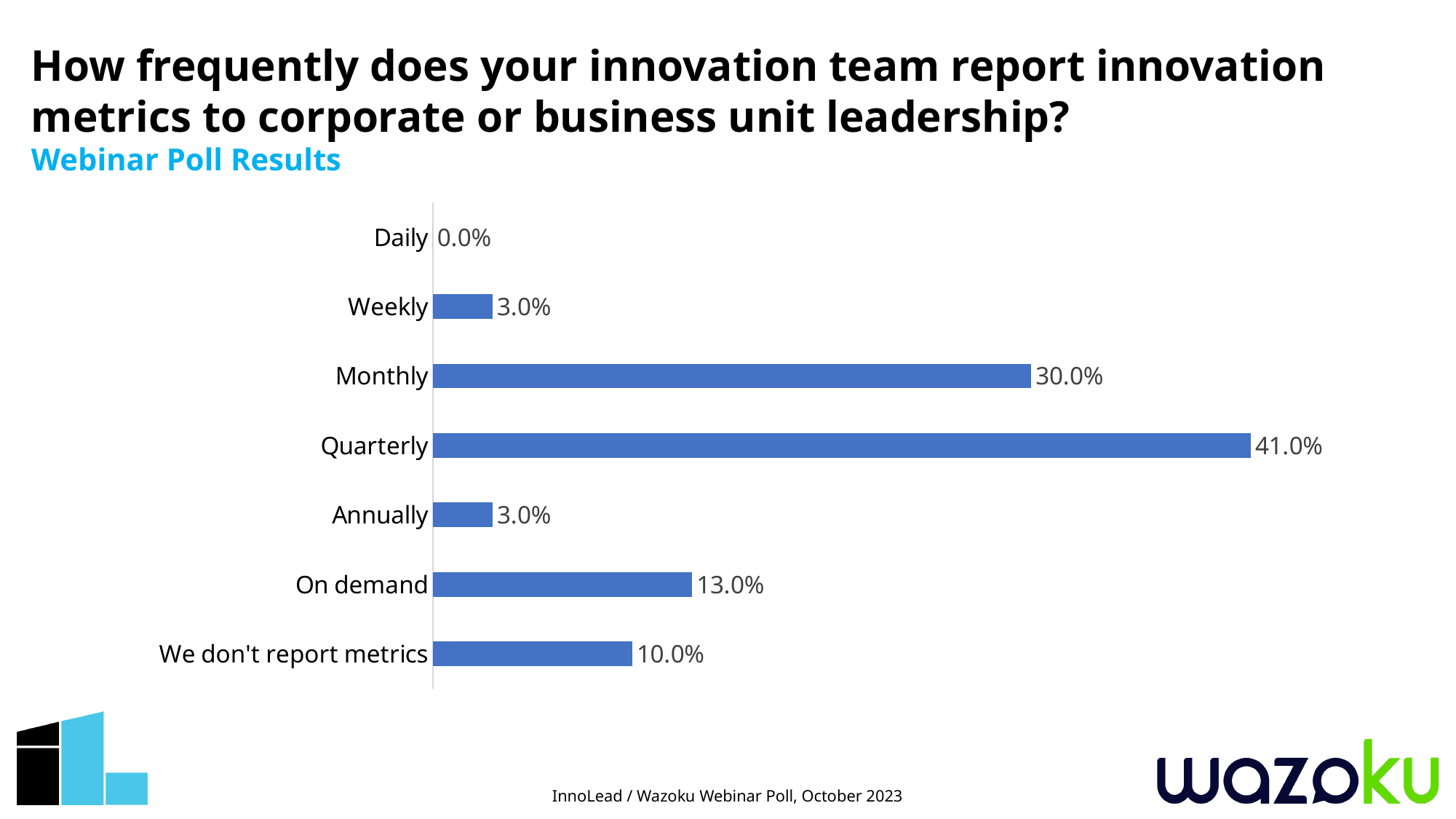
What is the subtitle shown in blue below the main title? Webinar Poll Results What is the difference between the Quarterly and Monthly values? 11.0% Which is larger, the value for Monthly or the value for On demand? Monthly What is the difference between the On demand and We don't report metrics values? 3.0% What is the value for We don't report metrics? 10.0% Which category has the lowest value? Daily What is the value for Monthly? 30.0% What kind of chart is shown on the slide? Bar chart What percentage of respondents report innovation metrics quarterly? 41.0% Which category has the highest value? Quarterly How many categories are shown in the chart? 7 What is the value for On demand? 13.0%